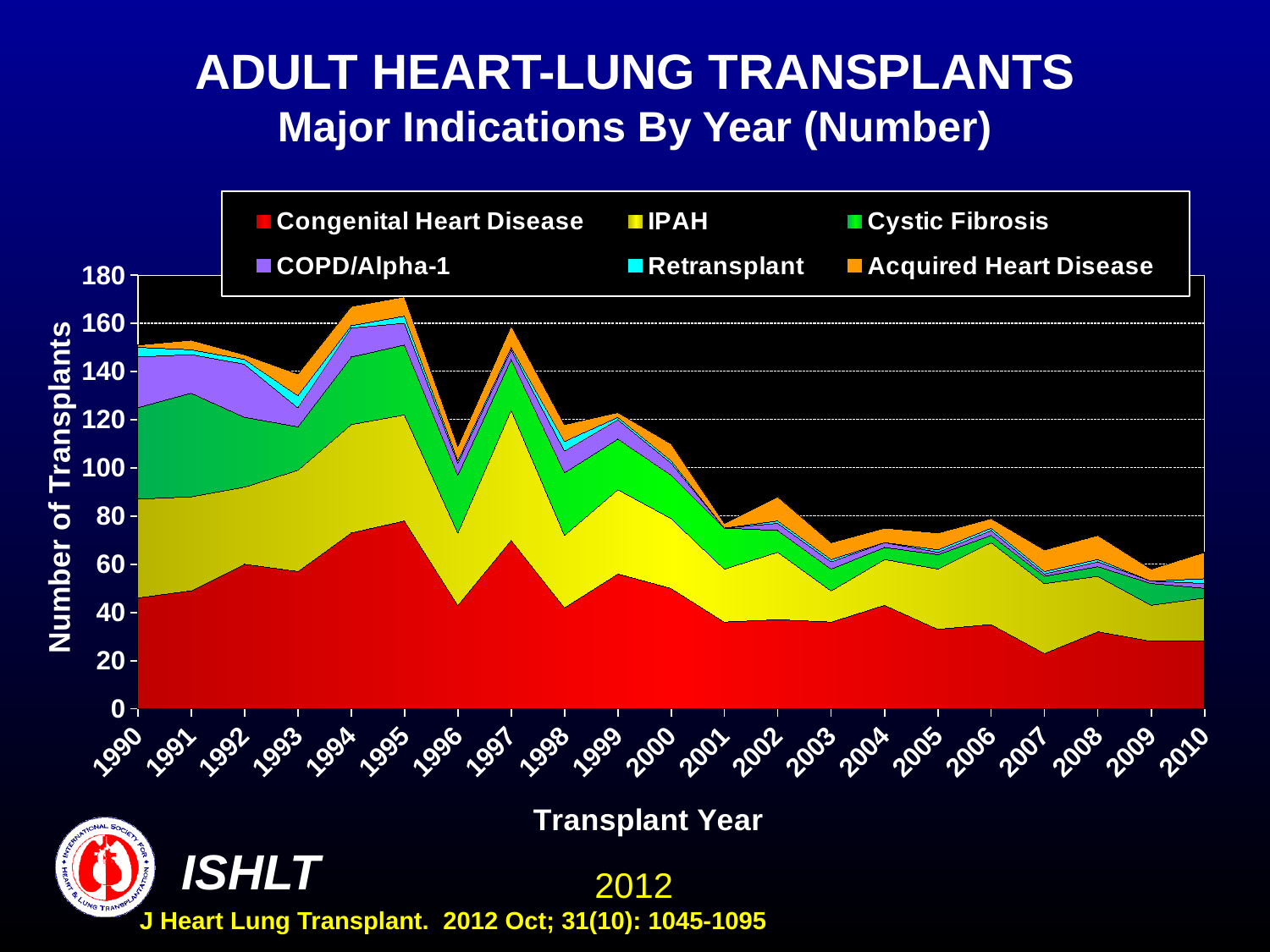
Which colour represents Congenital Heart Disease in the legend? Red Which year has the highest total number of transplants? 1995 Is the total number of transplants in 2001 greater or less than 100? less Is the total number of transplants in 2010 greater or less than 80? less Is the number of Congenital Heart Disease transplants in 2007 greater or less than 40? less What kind of chart is shown on the slide? Stacked area chart What is the label of the x axis? Transplant Year How many series does the legend list? 6 Which year has the larger total number of transplants, 1990 or 2010? 1990 Overall, do the total number of heart-lung transplants rise or fall from 1990 to 2010? Fall How many transplant years are plotted along the x axis? 21